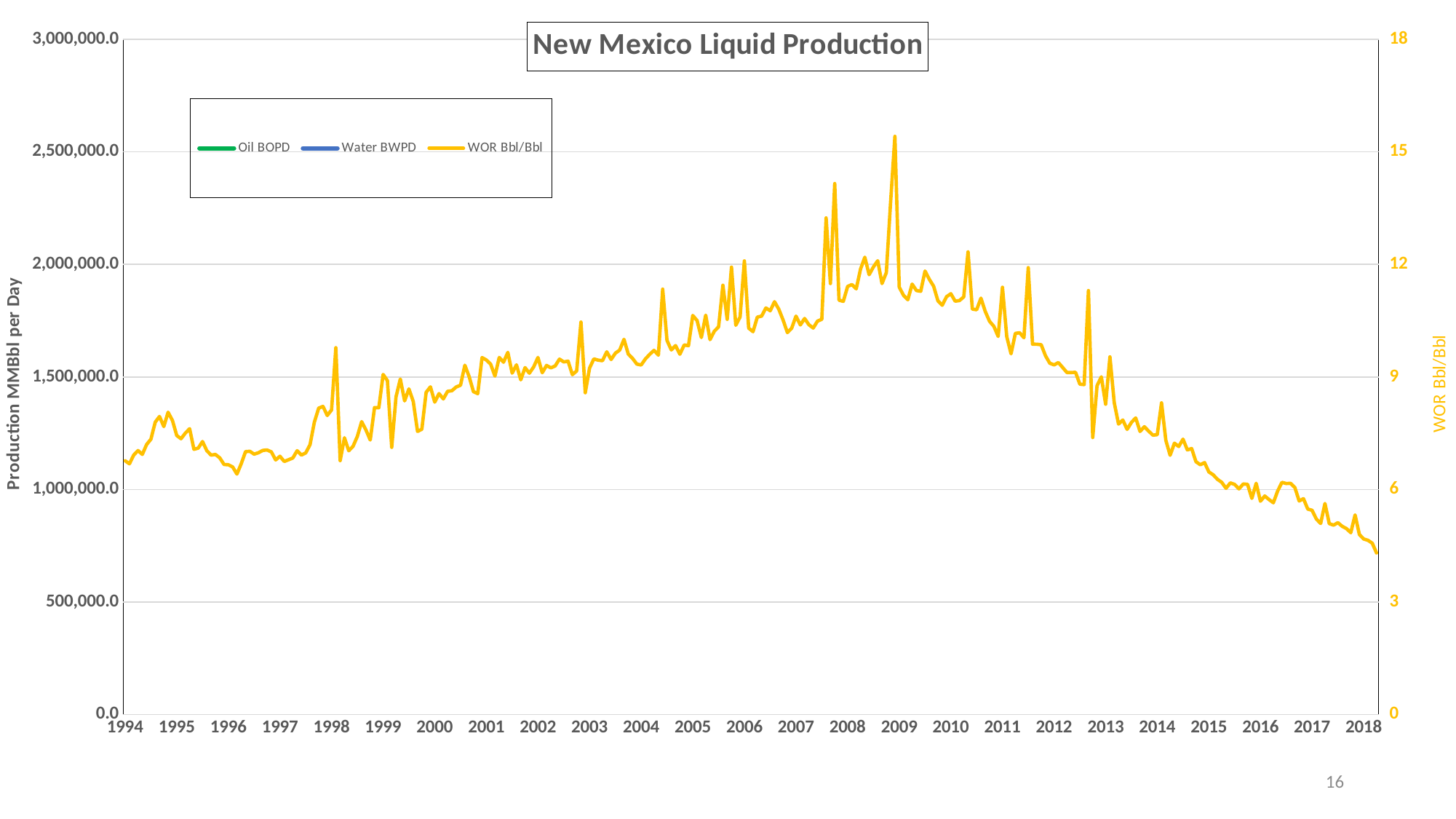
Does the highest WOR Bbl/Bbl spike occur before or after 2005? after Is the highest WOR Bbl/Bbl spike greater or less than 12? greater Which series is drawn in yellow? WOR Bbl/Bbl Is the WOR Bbl/Bbl value around 2012 larger or smaller than the value around 2017? larger What is the title of the chart? New Mexico Liquid Production What kind of chart is shown on the slide? line chart Is the WOR Bbl/Bbl value around 2016 greater or less than 9? less Does the WOR Bbl/Bbl line generally rise or fall between 1996 and 2008? rise Is the WOR Bbl/Bbl value at the end of the series in 2018 greater or less than 6? less How many series does the legend list? 3 Does the WOR Bbl/Bbl line generally rise or fall between 2009 and 2018? fall